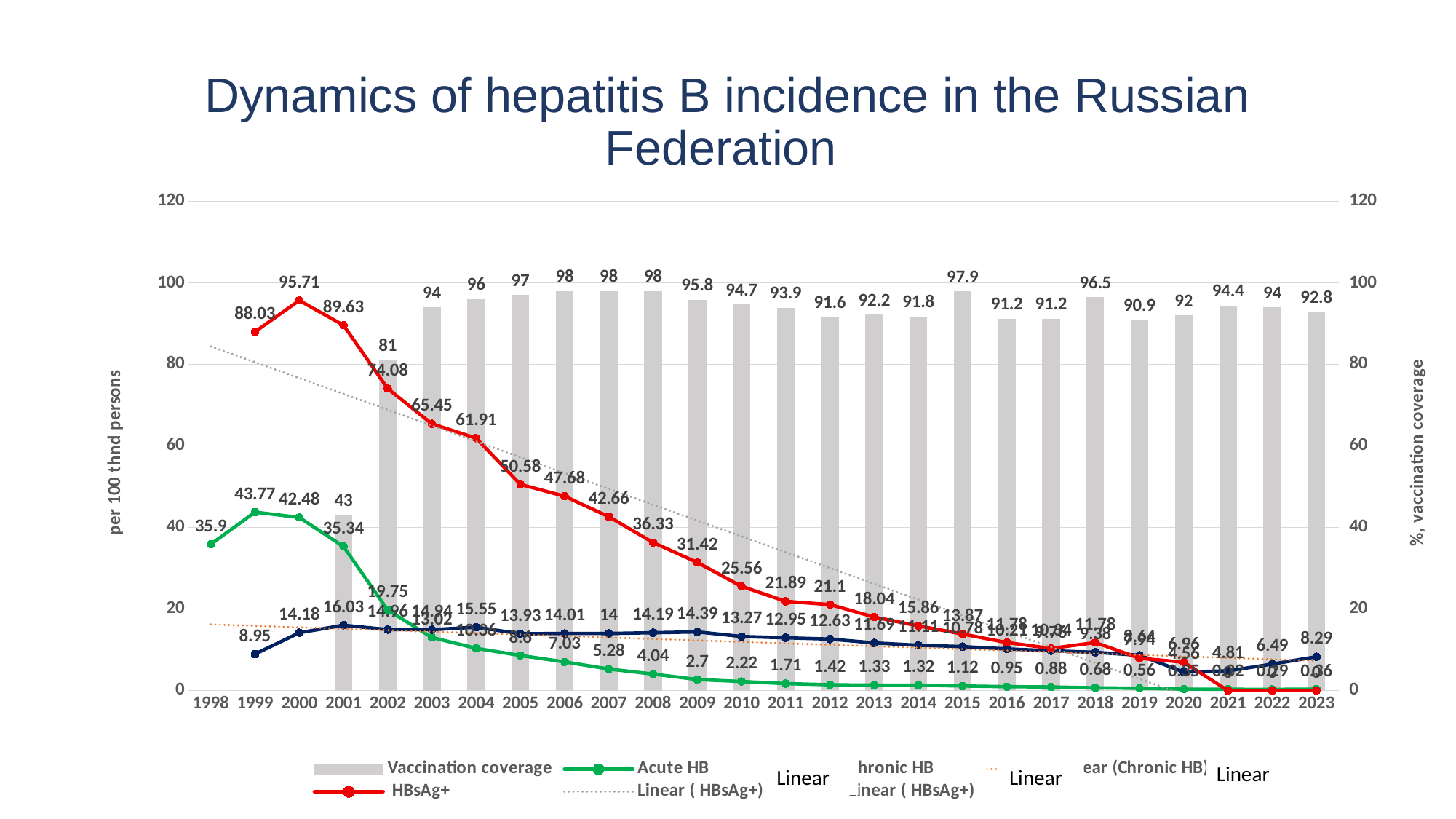
In which year is the HBsAg+ value highest? 2000 What is the HBsAg+ value shown for 2000? 95.71 What is the highest vaccination coverage value shown on the chart? 98 What is the Acute HB value shown for 1999? 43.77 What is the vaccination coverage value shown for 2002? 81 What is the difference between the HBsAg+ values for 2000 and 1999? 7.68 Does the HBsAg+ line rise or fall from 2000 to 2023? Falls Which year has the larger Acute HB value, 1999 or 2000? 1999 By how much did vaccination coverage increase from 2002 to 2003? 13 What is the Chronic HB value shown for 2001? 16.03 In which year is the vaccination coverage bar lowest? 2001 What is the label of the left vertical axis? per 100 thnd persons